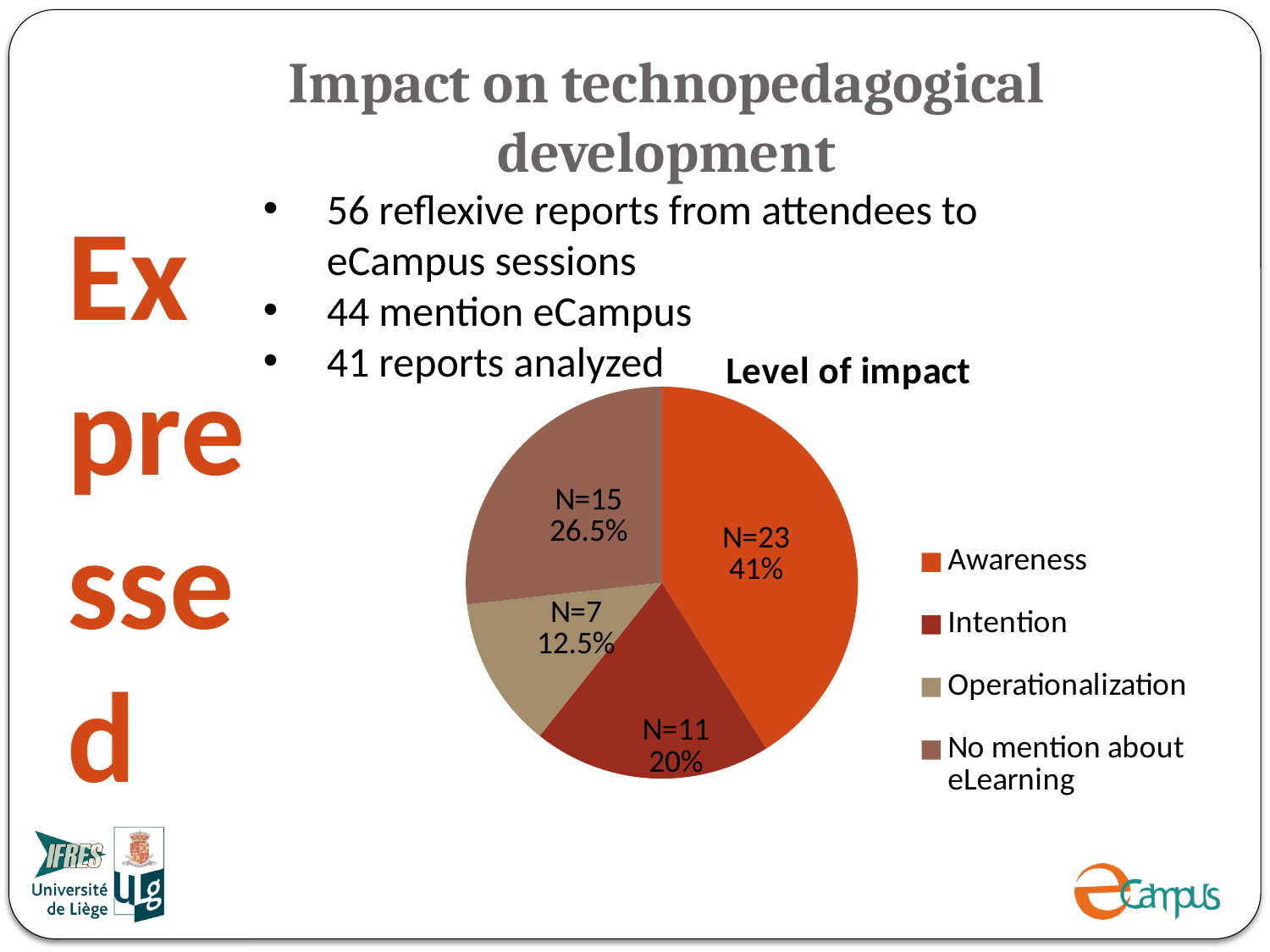
What is the N value for the Awareness slice? N=23 What percentage share does the No mention about eLearning slice have? 26.5% Which slice is larger, Intention or No mention about eLearning? No mention about eLearning Which category has the smallest slice of the pie? Operationalization How many entries does the legend list? 4 What is the difference in N between the Awareness and Intention slices? 12 What is the N value for the Operationalization slice? N=7 What type of chart is shown on the slide? Pie chart What is the title of the chart? Level of impact Which category has the largest slice of the pie? Awareness What percentage share does the Intention slice have? 20% How many slices does the pie chart have? 4